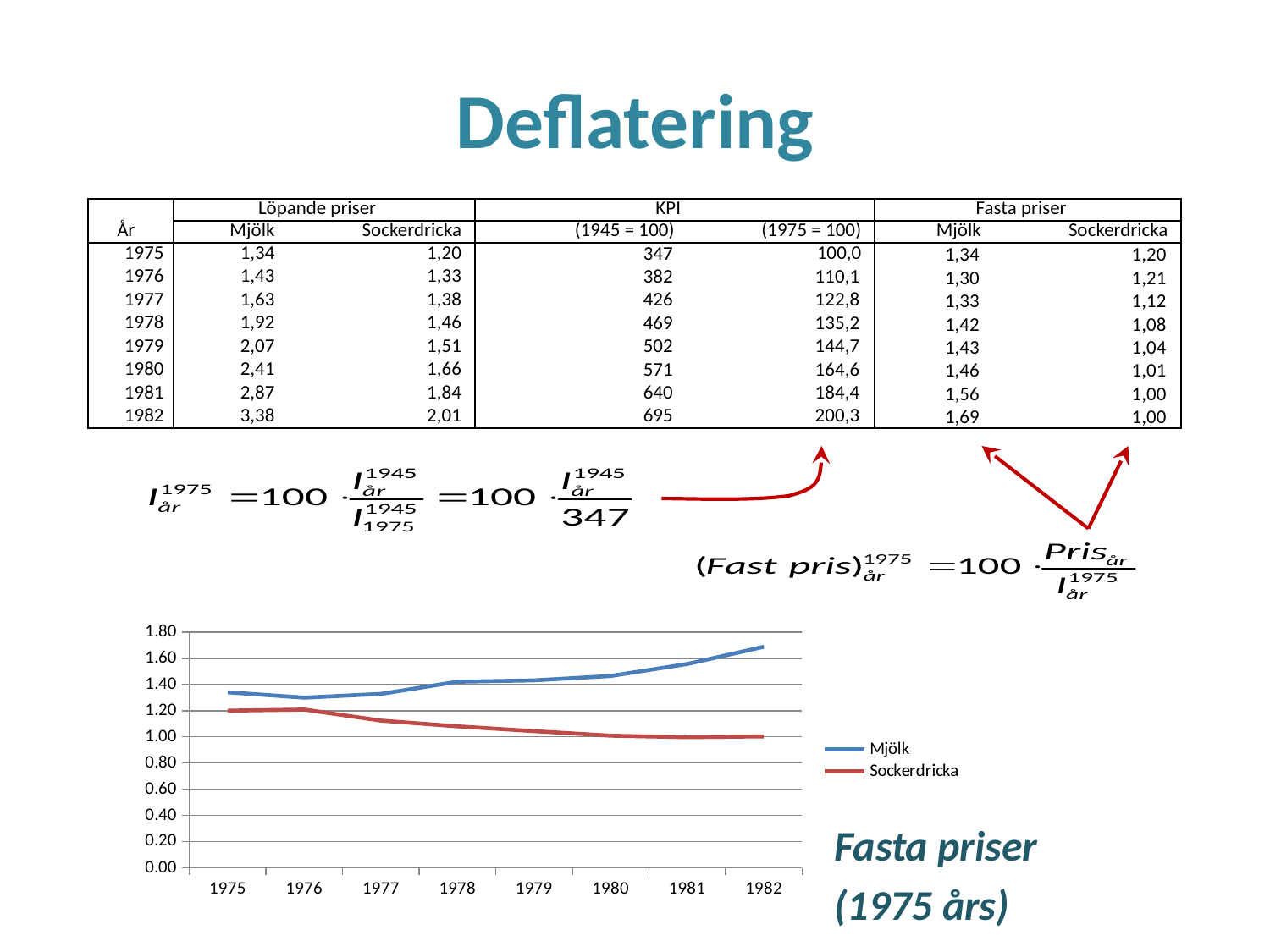
What is the value of Sockerdricka in 1982 on the chart? 1.00 Is the value for Sockerdricka in 1980 greater or less than 1.20? less In 1982, which series has the larger value, Mjölk or Sockerdricka? Mjölk What kind of chart is shown at the bottom of the slide? line chart How many series does the chart legend list? 2 How many years are plotted along the x axis of the chart? 8 Does the Sockerdricka line rise or fall overall from 1975 to 1982? fall Is the value for Mjölk in 1975 greater or less than 1.20? greater In which year does the Mjölk line reach its highest value? 1982 Does the Mjölk line rise or fall overall from 1975 to 1982? rise Is the value for Mjölk in 1982 greater or less than 1.60? greater What colour is the Mjölk line in the chart? blue